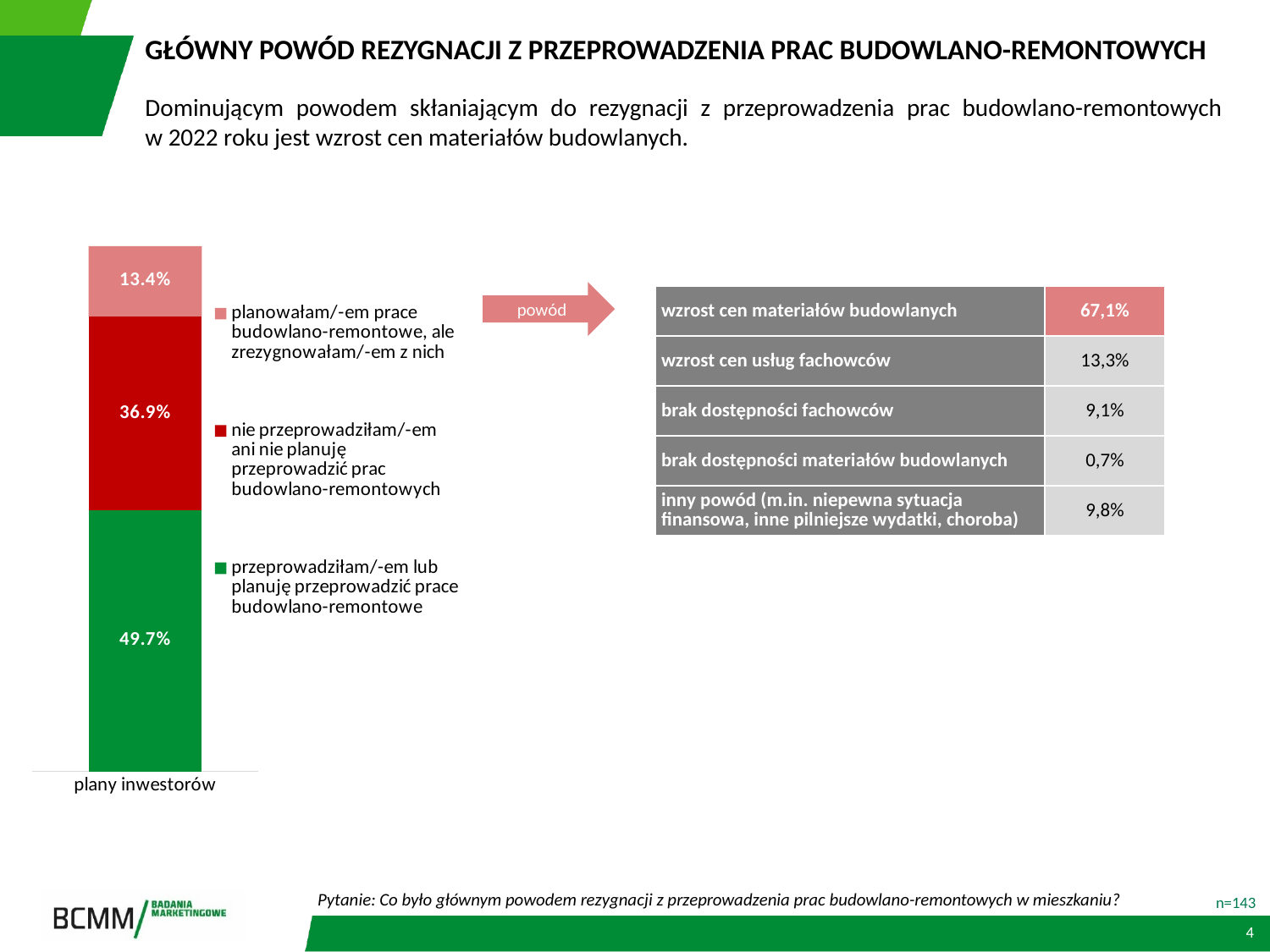
What is the difference between the value for "przeprowadziłam/-em lub planuję przeprowadzić prace budowlano-remontowe" and the value for "nie przeprowadziłam/-em ani nie planuję przeprowadzić prac budowlano-remontowych"? 12.8% What kind of chart is shown on the slide? stacked bar chart How many categories are shown on the x axis of the chart? 1 Which series has the highest value in the stacked bar? przeprowadziłam/-em lub planuję przeprowadzić prace budowlano-remontowe What is the total of the stacked bar for "plany inwestorów"? 100% Which series has the lowest value in the stacked bar? planowałam/-em prace budowlano-remontowe, ale zrezygnowałam/-em z nich What is the value for the series "przeprowadziłam/-em lub planuję przeprowadzić prace budowlano-remontowe"? 49.7% Which is larger: the value for "nie przeprowadziłam/-em ani nie planuję przeprowadzić prac budowlano-remontowych" or the value for "planowałam/-em prace budowlano-remontowe, ale zrezygnowałam/-em z nich"? nie przeprowadziłam/-em ani nie planuję przeprowadzić prac budowlano-remontowych What is the value for the series "planowałam/-em prace budowlano-remontowe, ale zrezygnowałam/-em z nich"? 13.4% How many series does the chart legend list? 3 What is the value for the series "nie przeprowadziłam/-em ani nie planuję przeprowadzić prac budowlano-remontowych"? 36.9% What colour is the segment for "przeprowadziłam/-em lub planuję przeprowadzić prace budowlano-remontowe"? green